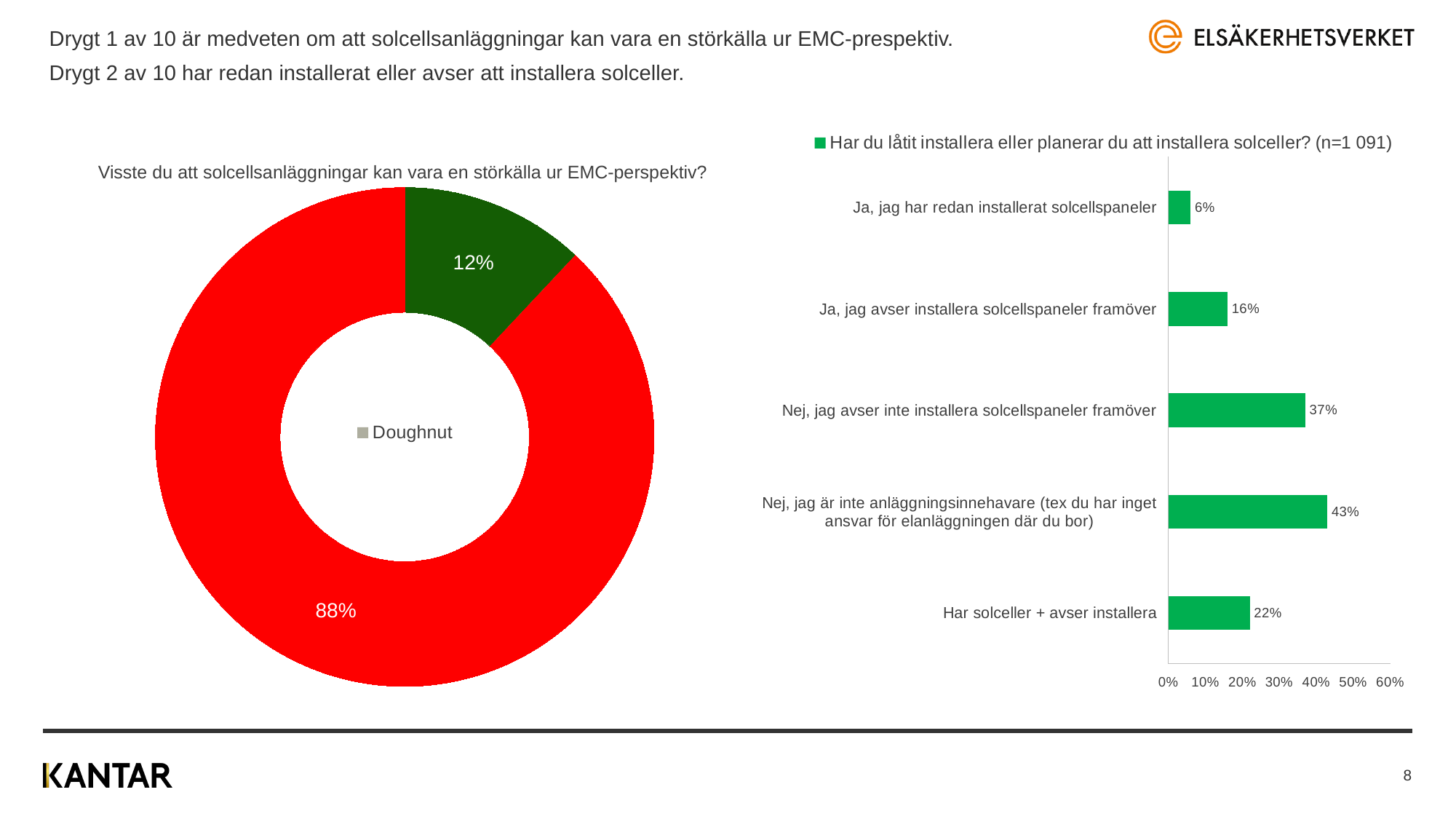
In the bar chart on the right, what is the value for "Har solceller + avser installera"? 22% How many categories are shown in the bar chart on the right? 5 In the bar chart on the right, what is the value for "Nej, jag avser inte installera solcellspaneler framöver"? 37% What kind of chart is the chart on the right? Bar chart In the bar chart on the right, which is larger: the value for "Nej, jag avser inte installera solcellspaneler framöver" or for "Har solceller + avser installera"? Nej, jag avser inte installera solcellspaneler framöver What is the title of the doughnut chart on the left? Visste du att solcellsanläggningar kan vara en störkälla ur EMC-perspektiv? In the doughnut chart on the left, what share does the green slice represent? 12% In the bar chart on the right, what is the value for "Ja, jag har redan installerat solcellspaneler"? 6% In the bar chart on the right, what is the difference between the values for "Nej, jag är inte anläggningsinnehavare" and "Ja, jag avser installera solcellspaneler framöver"? 27% In the bar chart on the right, which category has the lowest value? Ja, jag har redan installerat solcellspaneler In the doughnut chart on the left, what share does the red slice represent? 88% In the bar chart on the right, which category has the highest value? Nej, jag är inte anläggningsinnehavare (tex du har inget ansvar för elanläggningen där du bor)